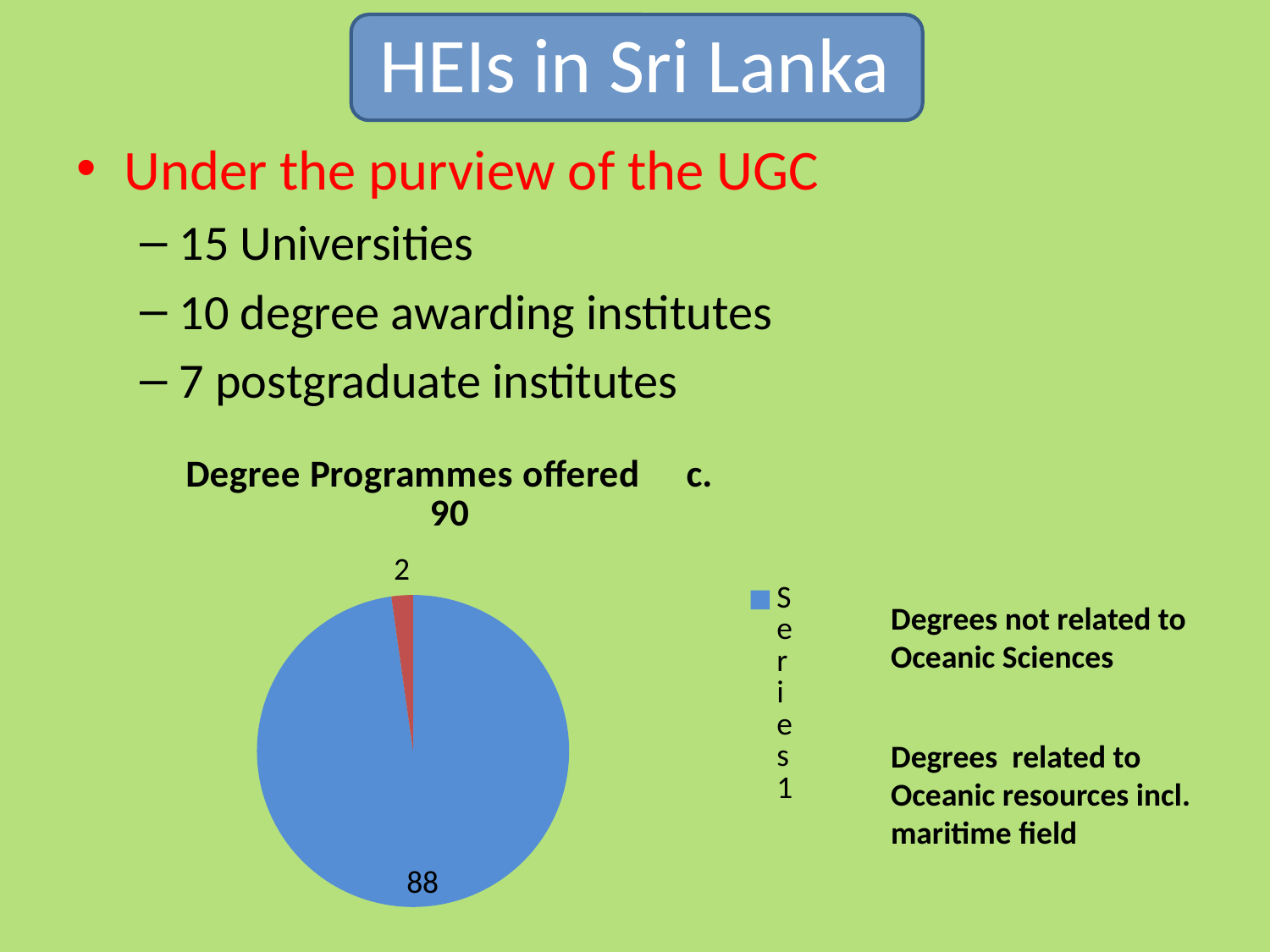
What is the value of the largest slice in the pie chart? 88 What is the title of the chart on the slide? Degree Programmes offered c. 90 What is the difference between the two slice values in the pie chart? 86 What is the value of the smallest slice in the pie chart? 2 What is the value shown on the red slice of the pie chart? 2 What is the value shown on the blue slice of the pie chart? 88 What kind of chart is shown on the slide? pie chart Which slice is larger in the pie chart, the blue one or the red one? the blue one How many slices does the pie chart have? 2 What is the total of the two slice values in the pie chart? 90 What series name appears in the chart legend? Series 1 How many series does the chart legend list? 1